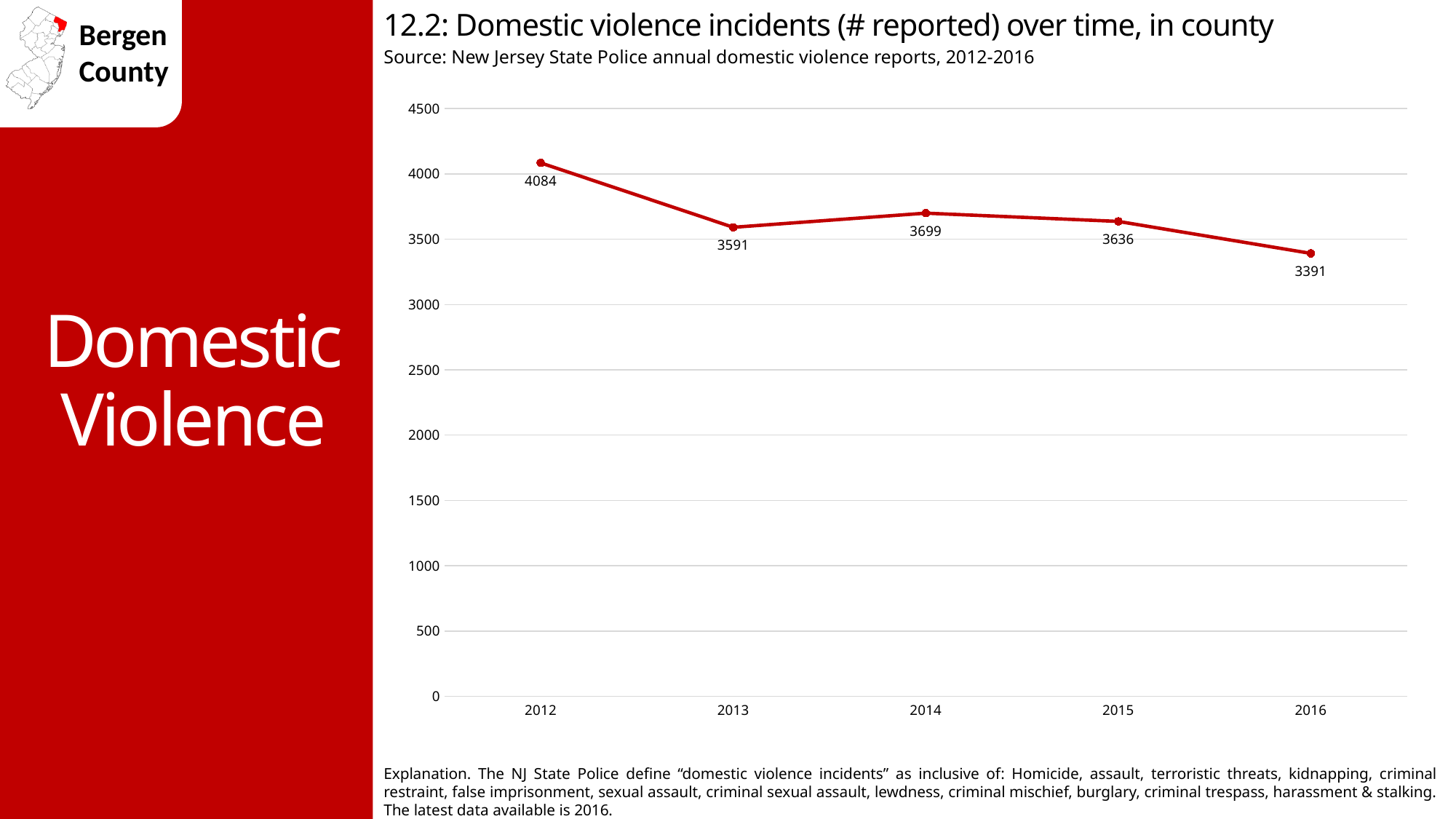
How many years are plotted on the chart? 5 How many domestic violence incidents were reported in 2012? 4084 Which year has the highest number of reported domestic violence incidents? 2012 Is the value for 2016 greater or less than 3500? less What is the value for 2016? 3391 What kind of chart is shown on the slide? line chart What is the value for 2014? 3699 Which year has a larger value, 2013 or 2015? 2015 What is the difference between the 2012 and 2016 values? 693 Do the values generally rise or fall from 2012 to 2016? fall Which year has the lowest number of reported domestic violence incidents? 2016 What is the difference between the 2014 and 2013 values? 108